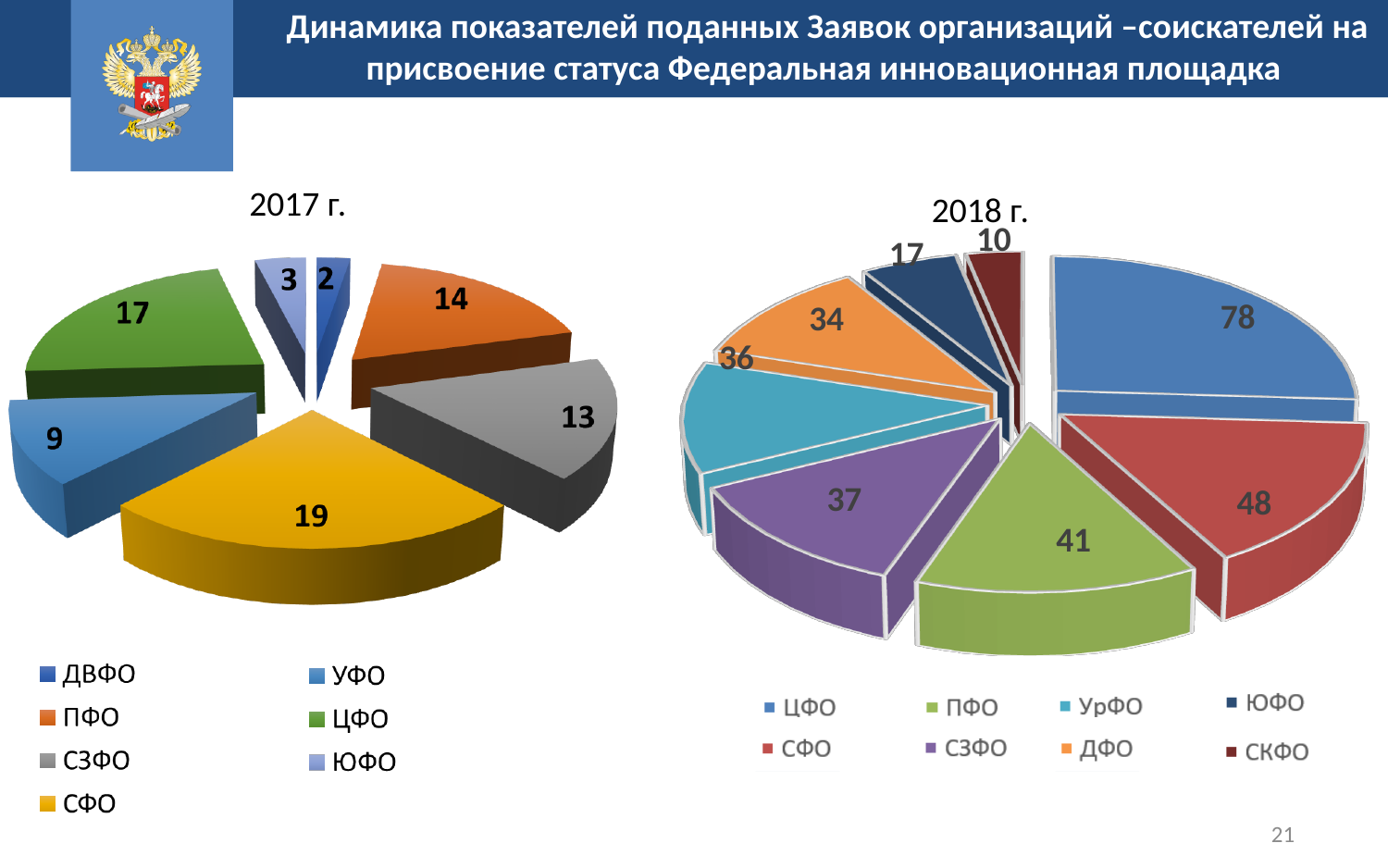
In the 2017 г. pie chart, which is larger: ЦФО or ПФО? ЦФО In the 2017 г. pie chart, how many regions (slices) are shown? 7 In the 2018 г. pie chart, what is the value for ЮФО? 17 In the 2018 г. pie chart, what is the value for ЦФО? 78 In the 2017 г. pie chart, which region has the largest slice? СФО What type of chart is used for the 2018 г. data? Pie chart In the 2017 г. pie chart, what is the value for СФО? 19 In the 2017 г. pie chart, what is the total of all slices? 77 In the 2018 г. pie chart, what is the difference between the values for ЦФО and СФО? 30 In the 2018 г. pie chart, how many regions (slices) are shown? 8 In the 2017 г. pie chart, which region has the smallest slice? ДВФО In the 2018 г. pie chart, which region has the smallest slice? СКФО